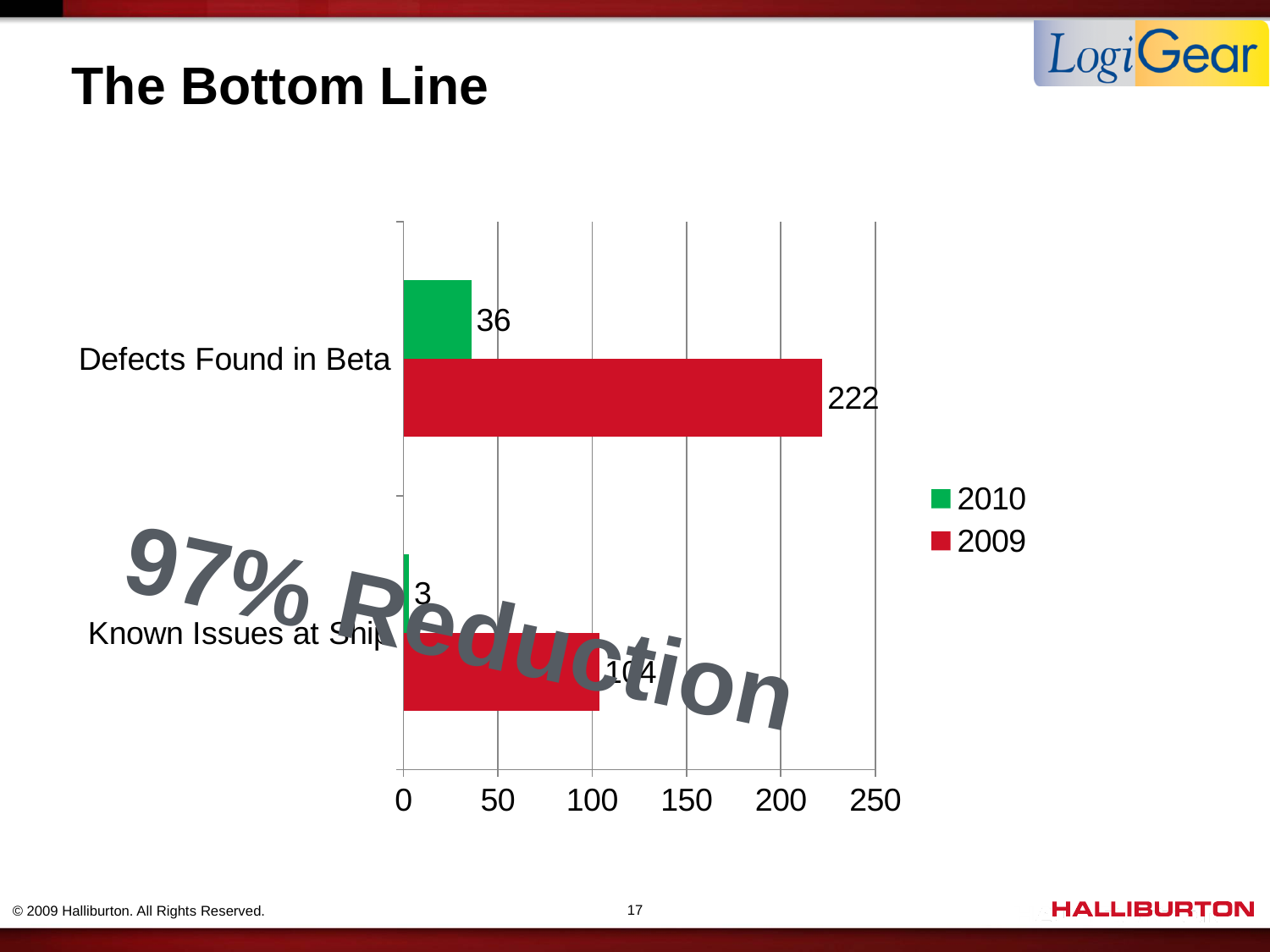
How many categories are shown on the chart? 2 How many series does the legend list? 2 What is the difference between the 2009 and 2010 values for Defects Found in Beta? 186 Is the 2009 value for Defects Found in Beta greater or less than 200? greater What is the 2010 value for Defects Found in Beta? 36 What type of chart is shown on the slide? bar chart Which is larger for Defects Found in Beta, the 2009 value or the 2010 value? 2009 What is the 2010 value for Known Issues at Ship? 3 What is the difference between the 2009 and 2010 values for Known Issues at Ship? 101 Which colour represents the 2010 series in the legend? green What is the 2009 value for Known Issues at Ship? 104 What is the 2009 value for Defects Found in Beta? 222